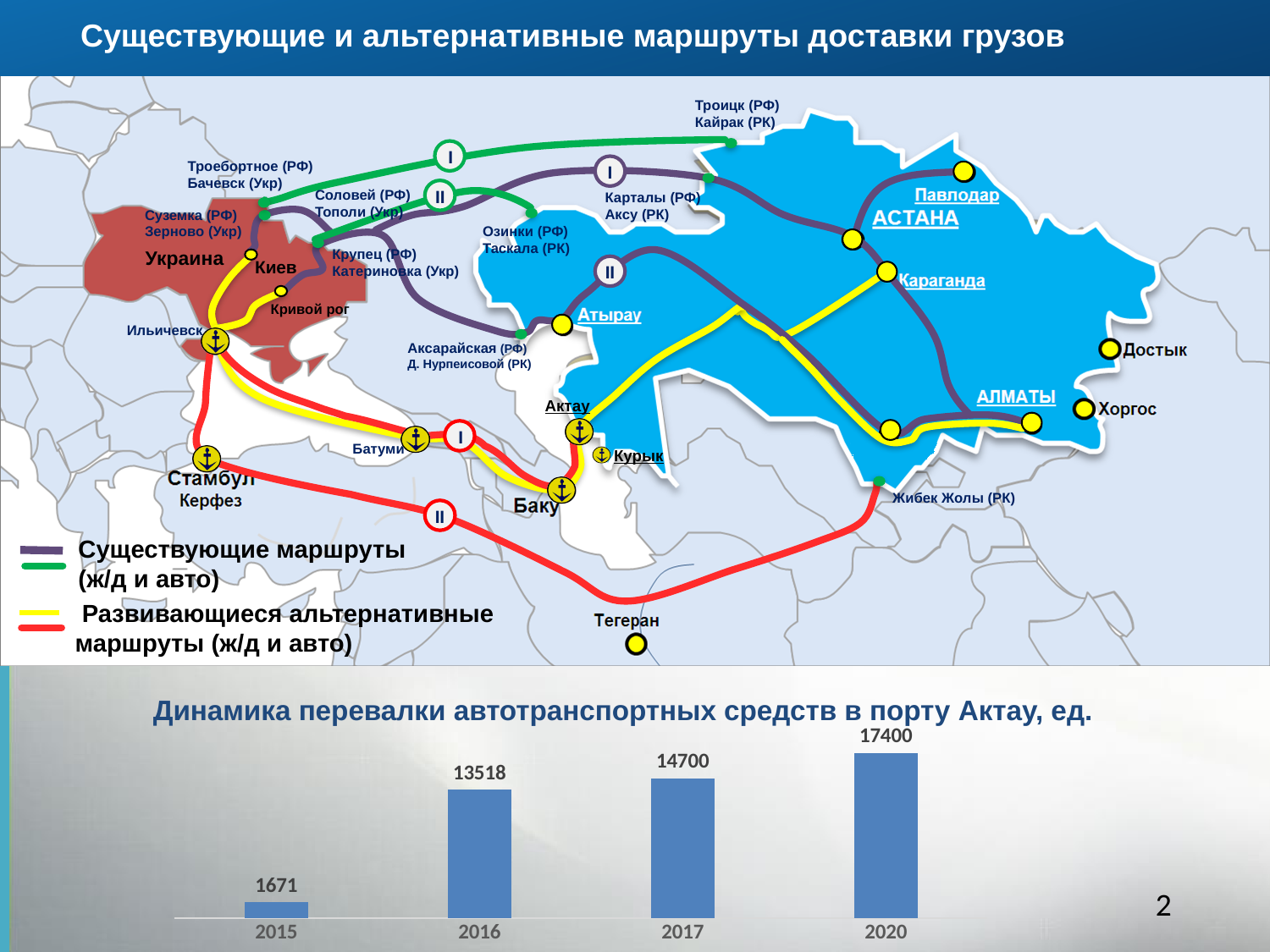
What is the value for 2017 in the bar chart? 14700 Do the values in the bar chart rise or fall from 2015 to 2020? Rise What kind of chart is shown at the bottom of the slide? Bar chart What is the value for 2015 in the chart 'Динамика перевалки автотранспортных средств в порту Актау, ед.'? 1671 Which year has the highest value in the bar chart? 2020 How many years are shown in the bar chart? 4 Which year has the lowest value in the bar chart? 2015 What is the difference between the values for 2016 and 2015 in the bar chart? 11847 What is the value for 2016 in the bar chart? 13518 What is the value for 2020 in the bar chart? 17400 What is the difference between the values for 2020 and 2017 in the bar chart? 2700 Which is larger in the bar chart, the value for 2016 or the value for 2017? 2017